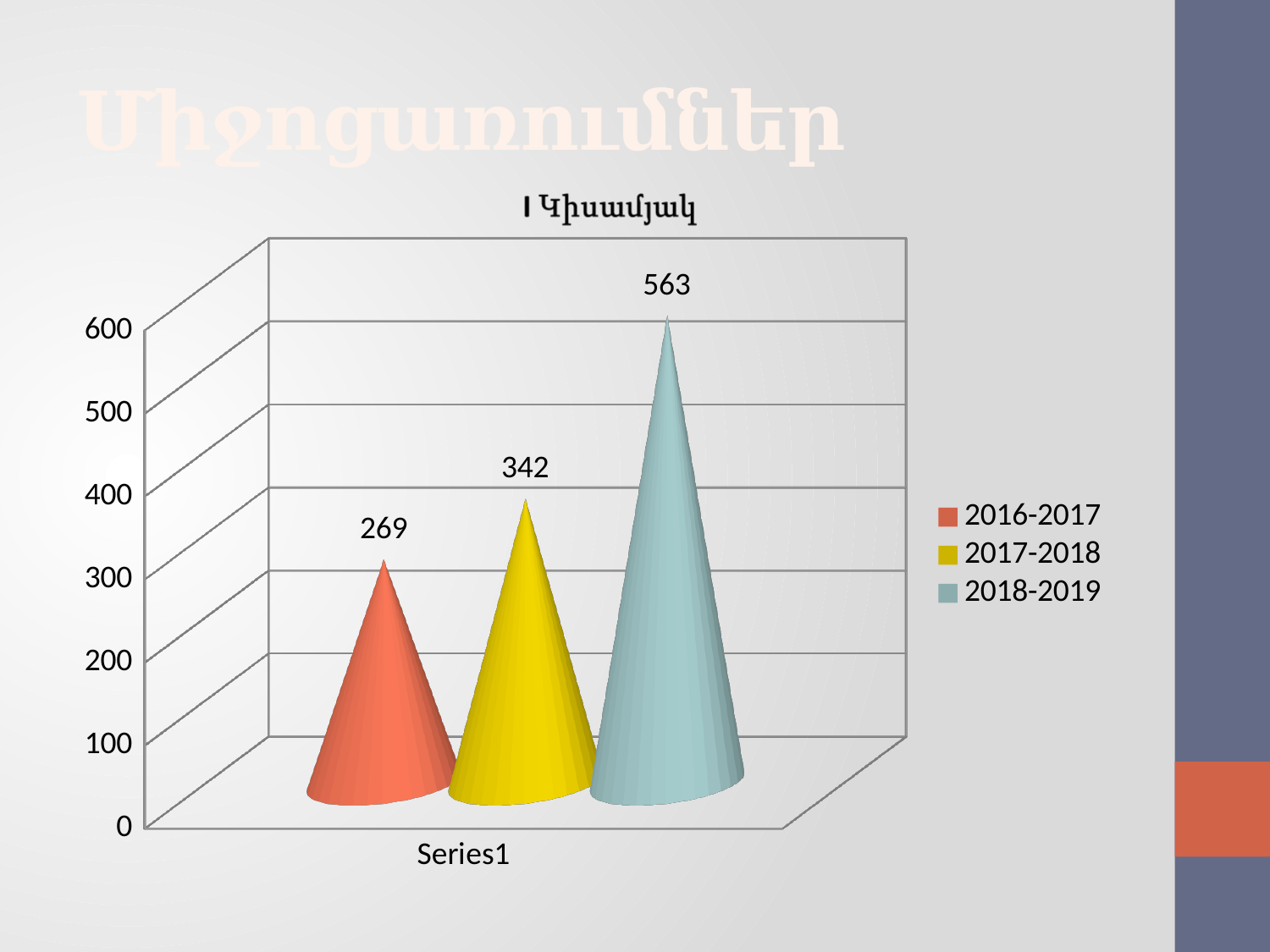
What kind of chart is shown on the slide? bar chart What is the value for 2017-2018? 342 Which series has the lowest value? 2016-2017 Which is larger, the value for 2017-2018 or the value for 2016-2017? 2017-2018 What is the title of the chart? I Կիսամյակ What is the value for 2016-2017? 269 What is the difference between the values for 2018-2019 and 2016-2017? 294 What is the value for 2018-2019? 563 Which series has the highest value? 2018-2019 Is the value for 2018-2019 greater or less than 500? greater What is the difference between the values for 2017-2018 and 2016-2017? 73 How many series does the legend list? 3